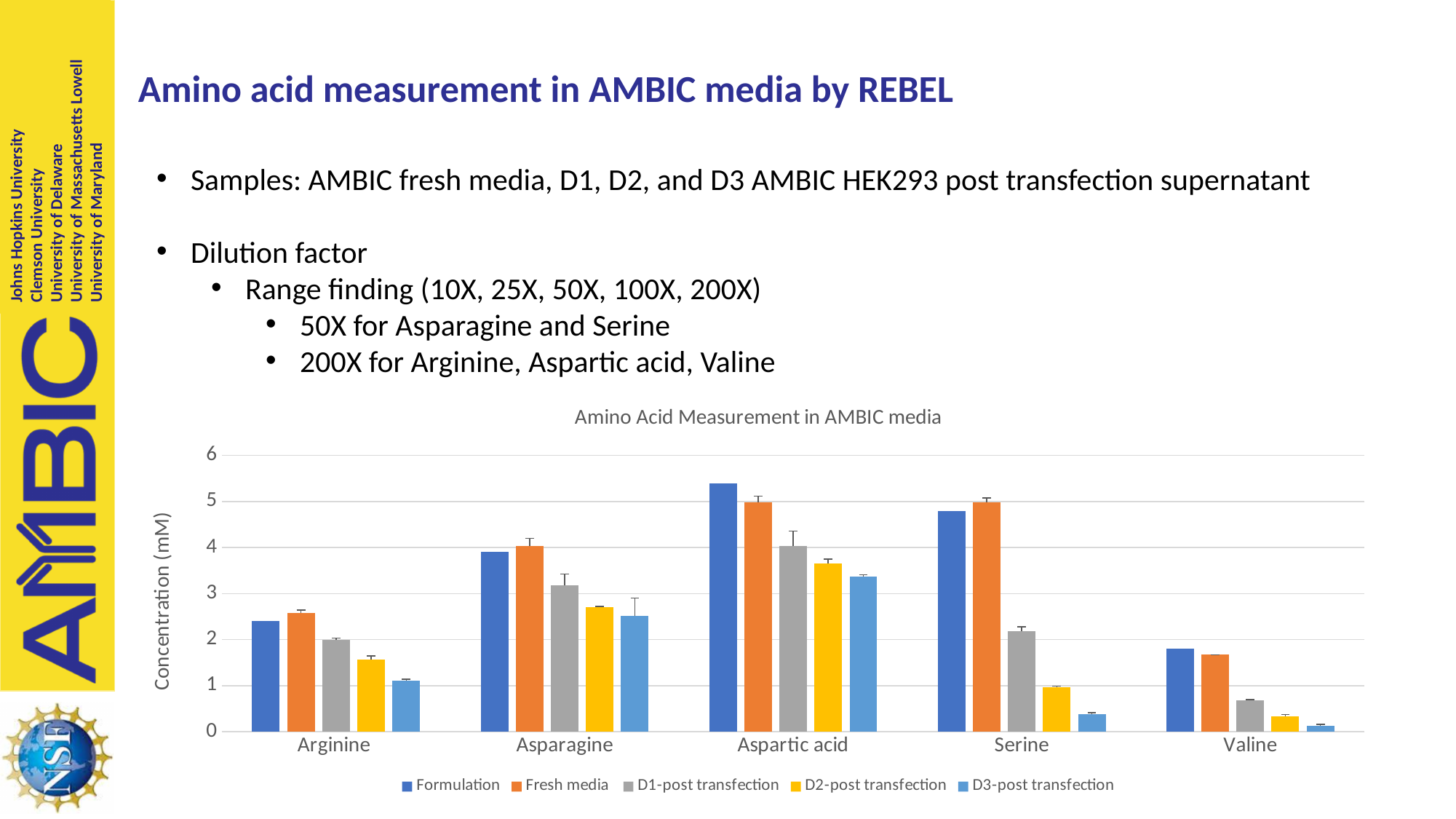
For Serine, do the values rise or fall from D1-post transfection to D3-post transfection? fall Is the Formulation value for Aspartic acid greater or less than 5? greater What kind of chart is shown on the slide? bar chart Is the D2-post transfection value for Arginine greater or less than 2? less For Asparagine, which is larger: the D1-post transfection value or the D2-post transfection value? D1-post transfection Is the D3-post transfection value for Serine greater or less than 1? less What is the label on the y axis of the chart? Concentration (mM) How many amino acids are shown on the x axis of the chart? 5 For Aspartic acid, which is larger: the Formulation value or the Fresh media value? Formulation How many series does the chart legend list? 5 Which amino acid has the highest Formulation value? Aspartic acid Which amino acid has the lowest D3-post transfection value? Valine